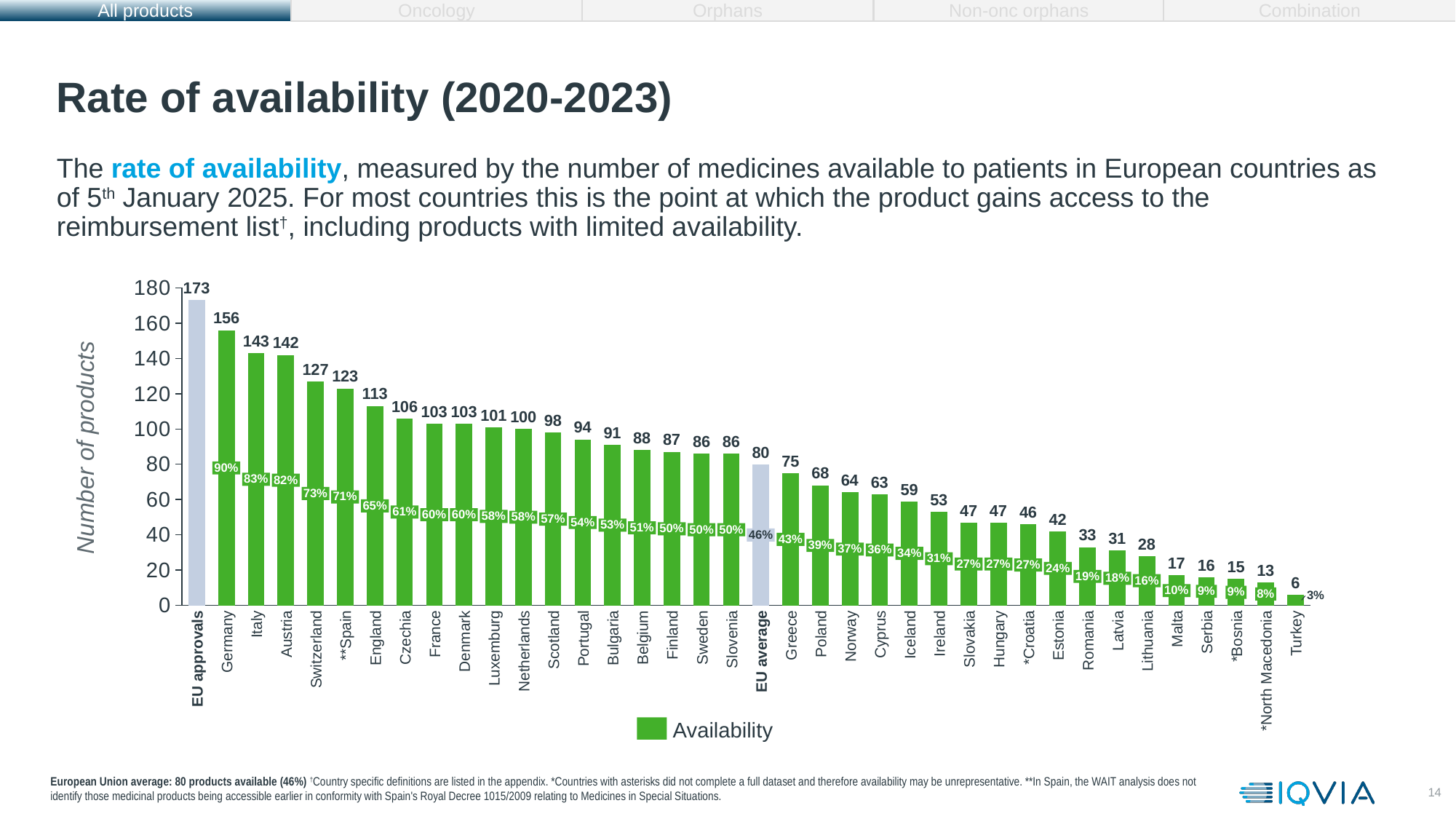
How many bars (categories) are shown on the chart? 38 What is the label of the y axis? Number of products What is the difference in number of products between EU approvals and the EU average? 93 Do the values generally rise or fall from left to right along the x axis? Fall Which has more products available, Greece or Norway? Greece What type of chart is shown on the slide? Bar chart Which country has the lowest number of products? Turkey Which bar has the highest value on the chart? EU approvals What is the difference in number of products between Germany and Italy? 13 What availability percentage is shown for Poland? 39% What is the number of products for the EU average bar? 80 What is the number of products for Germany? 156